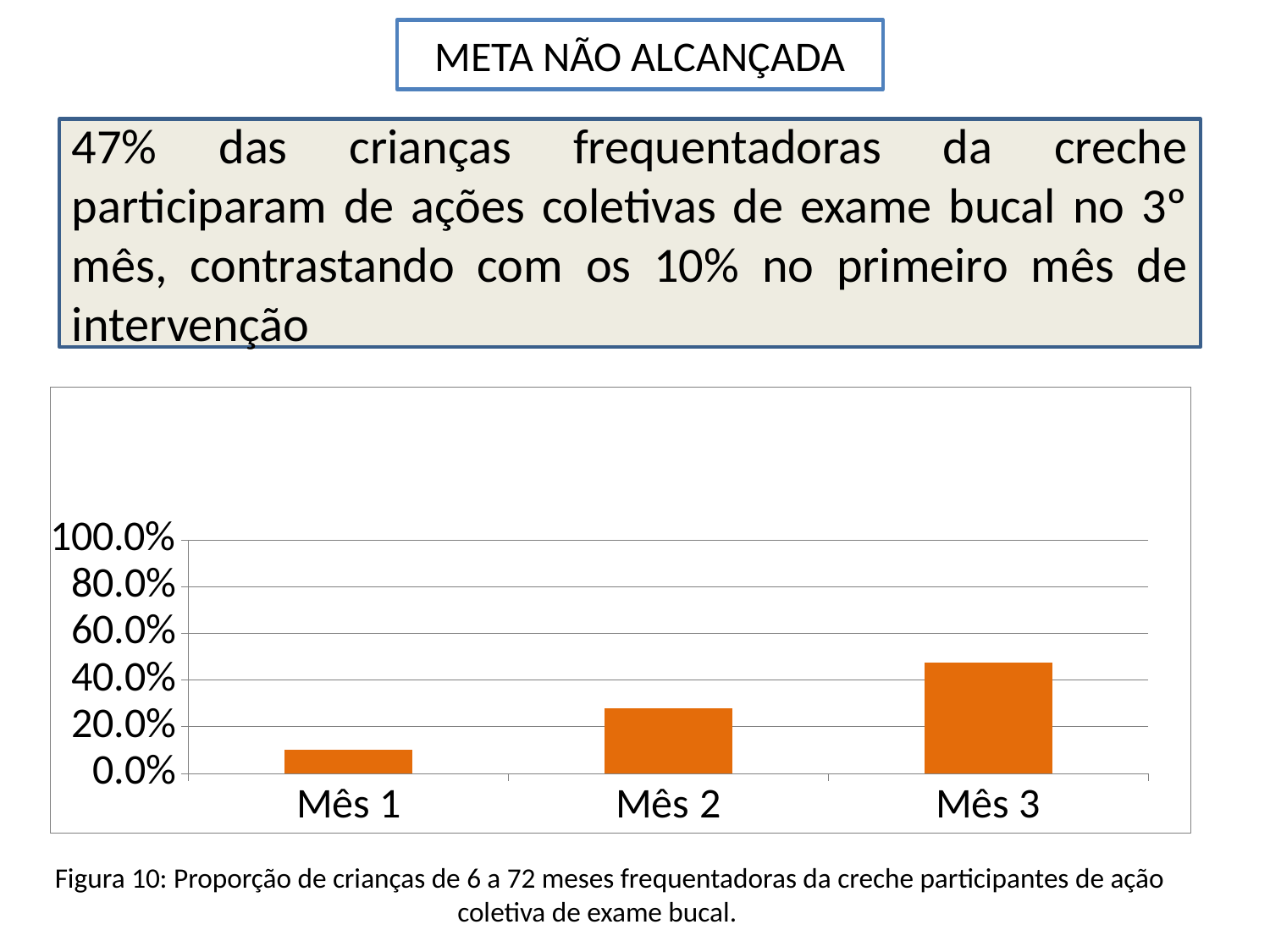
What colour are the bars in the chart? orange Which month has the highest bar in the chart? Mês 3 How many categories (months) are plotted in the chart? 3 Is the value for Mês 3 greater or less than 40.0%? greater Is the value for Mês 2 greater or less than 40.0%? less Is the value for Mês 3 greater or less than 60.0%? less Which is larger, the value for Mês 2 or the value for Mês 1? Mês 2 What kind of chart is shown on the slide? bar chart Which month has the lowest bar in the chart? Mês 1 Do the values rise or fall from Mês 1 to Mês 3? rise